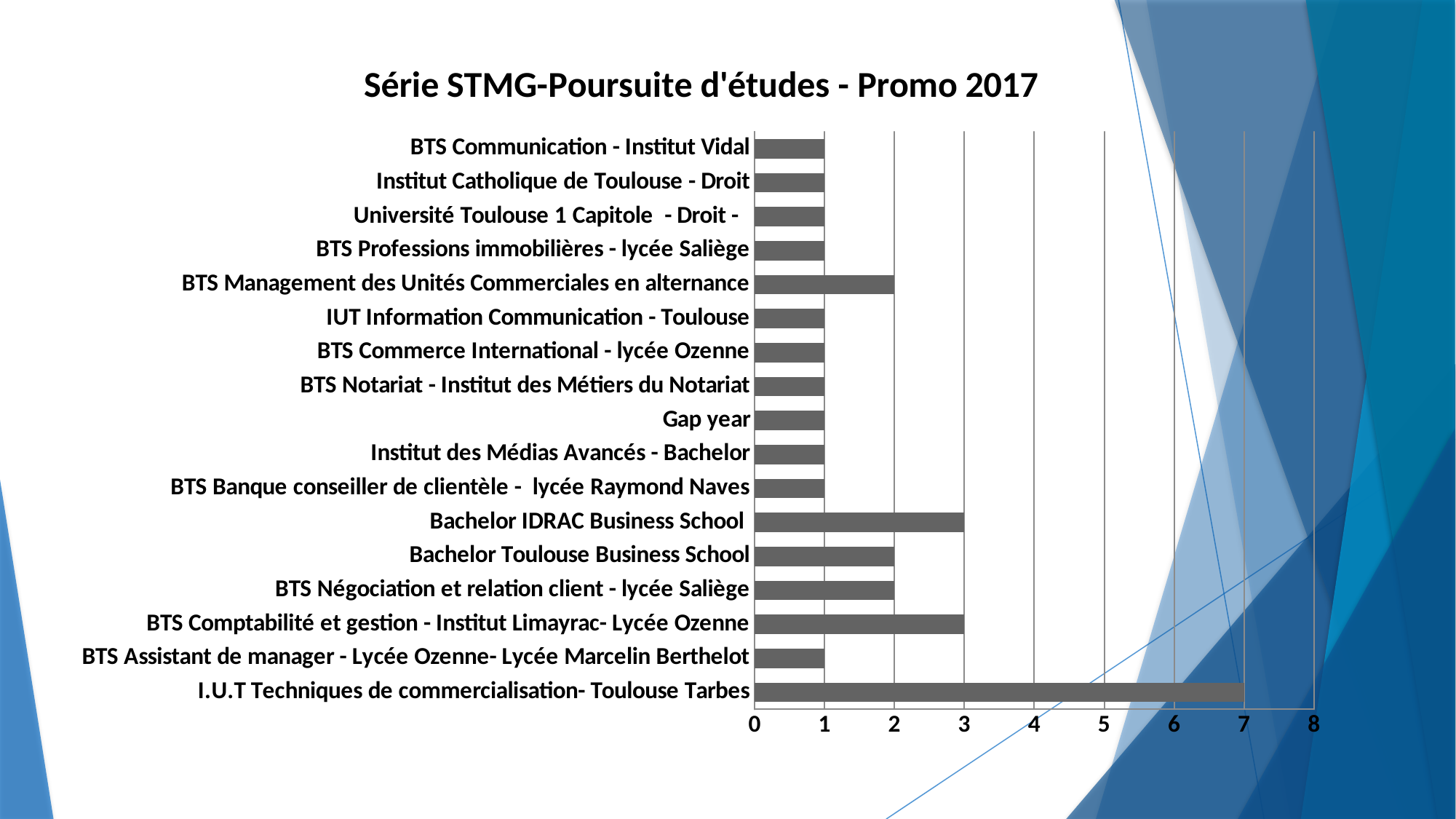
What type of chart is shown on the slide? Bar chart What is the title of the chart? Série STMG-Poursuite d'études - Promo 2017 What is the value for BTS Comptabilité et gestion - Institut Limayrac- Lycée Ozenne? 3 What is the value for I.U.T Techniques de commercialisation- Toulouse Tarbes? 7 What is the value for Gap year? 1 What is the value for Bachelor Toulouse Business School? 2 Which category has the highest value? I.U.T Techniques de commercialisation- Toulouse Tarbes What is the value for Bachelor IDRAC Business School? 3 Is the value for I.U.T Techniques de commercialisation- Toulouse Tarbes greater or less than 5? greater What is the difference between the value for I.U.T Techniques de commercialisation- Toulouse Tarbes and the value for Bachelor IDRAC Business School? 4 Which is larger, the value for BTS Management des Unités Commerciales en alternance or the value for BTS Commerce International - lycée Ozenne? BTS Management des Unités Commerciales en alternance How many categories are plotted in the chart? 17